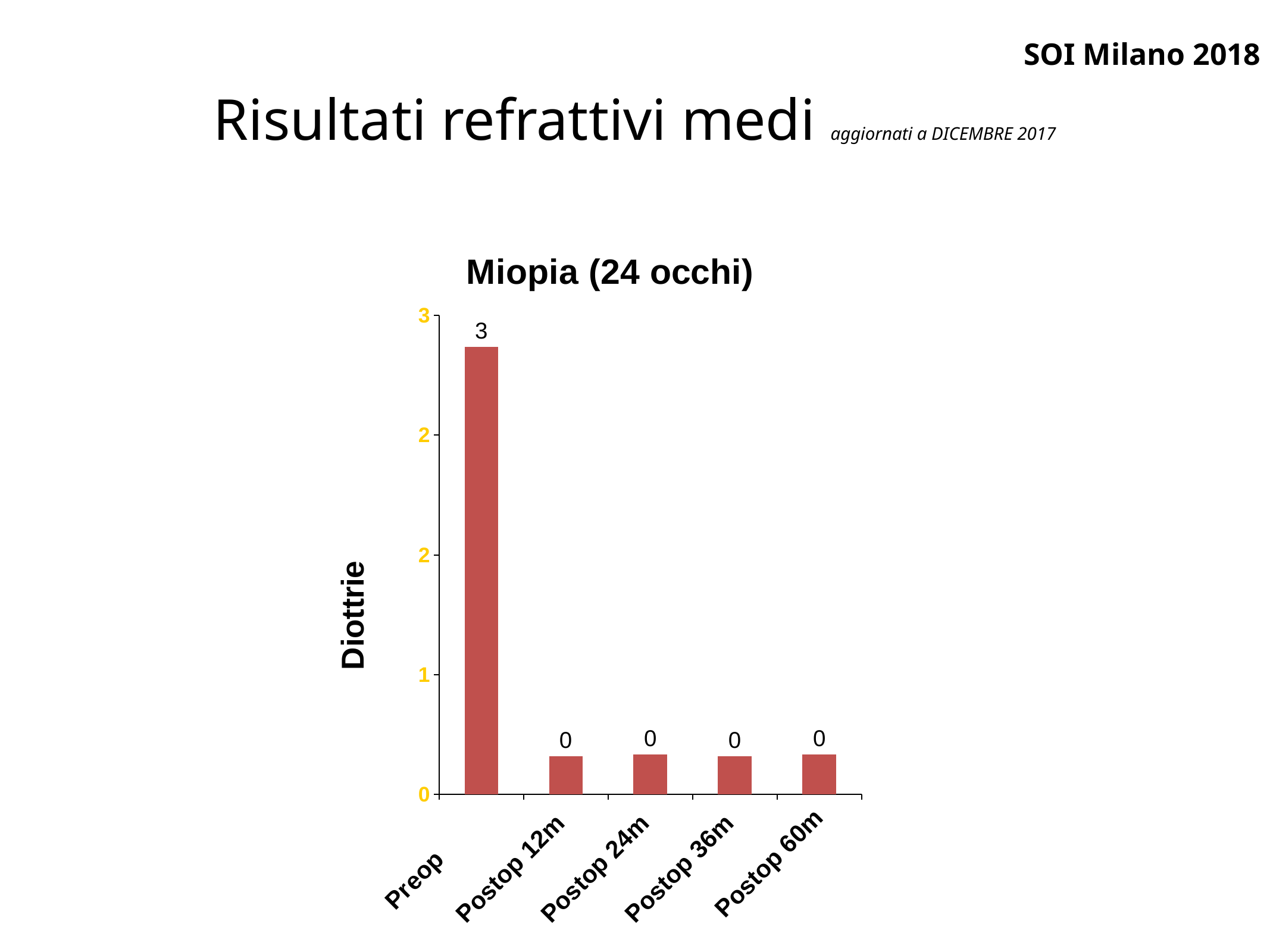
Which category has the highest value? Preop How many categories are plotted on the x axis? 5 What is the value labelled for Postop 60m? 0 Which is larger, the value for Preop or the value for Postop 36m? Preop What is the label of the vertical axis? Diottrie What type of chart is shown on the slide? bar chart Is the value for Preop greater or less than 2? greater What is the value labelled for Postop 12m? 0 Do the values rise or fall from Preop to Postop 12m? fall What is the title of the chart? Miopia (24 occhi) What is the value labelled for Preop? 3 What is the difference between the labelled values for Preop and Postop 24m? 3